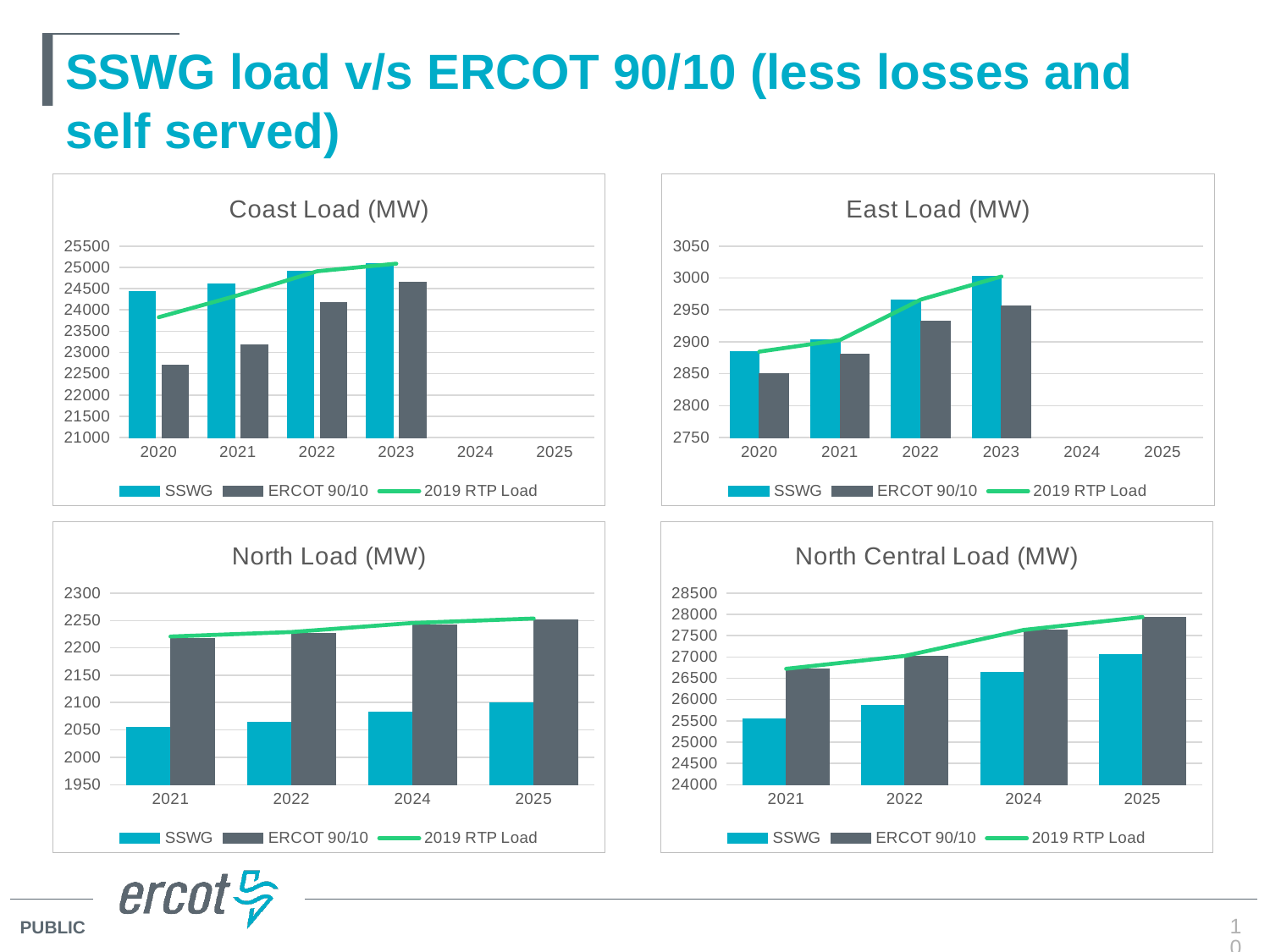
In the North Load (MW) chart, which is larger in 2025, SSWG or ERCOT 90/10? ERCOT 90/10 In the Coast Load (MW) chart, is the ERCOT 90/10 value for 2020 greater or less than 23000? less In the East Load (MW) chart, is the ERCOT 90/10 value for 2020 greater or less than 2900? less In the East Load (MW) chart, what kind of chart is used to plot the SSWG and ERCOT 90/10 series? bar chart In the North Central Load (MW) chart, which year has the highest ERCOT 90/10 value? 2025 In the North Load (MW) chart, is the SSWG value for 2021 greater or less than 2100? less In the Coast Load (MW) chart, which is larger in 2021, SSWG or ERCOT 90/10? SSWG In the North Load (MW) chart, how many years are shown on the x axis? 4 In the East Load (MW) chart, do the SSWG values rise or fall from 2020 to 2023? rise In the Coast Load (MW) chart, how many series does the legend list? 3